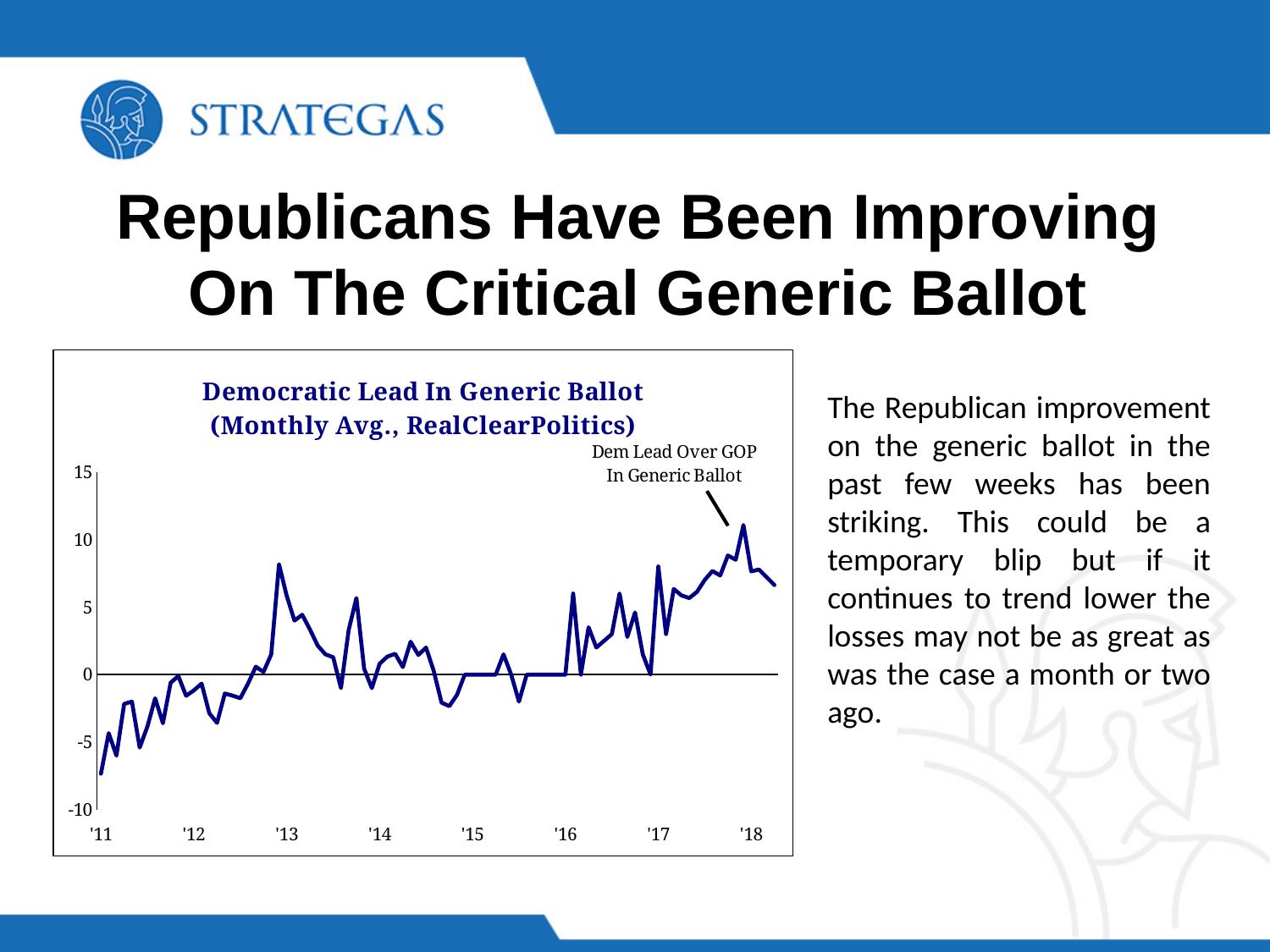
Overall, does the Democratic lead rise or fall from '11 to '18? rise Is the peak value reached around '13 greater or less than 5? greater How many year labels are shown on the x axis? 8 What does the annotation on the chart say the line represents? Dem Lead Over GOP In Generic Ballot Is the last plotted value (after '18) greater or less than 5? greater Is the value at the start of '11 greater or less than -5? less What kind of chart is shown on the slide? line chart How many data series are plotted on the chart? 1 What is the title of the chart? Democratic Lead In Generic Ballot (Monthly Avg., RealClearPolitics) Around which year does the line reach its lowest point? '11